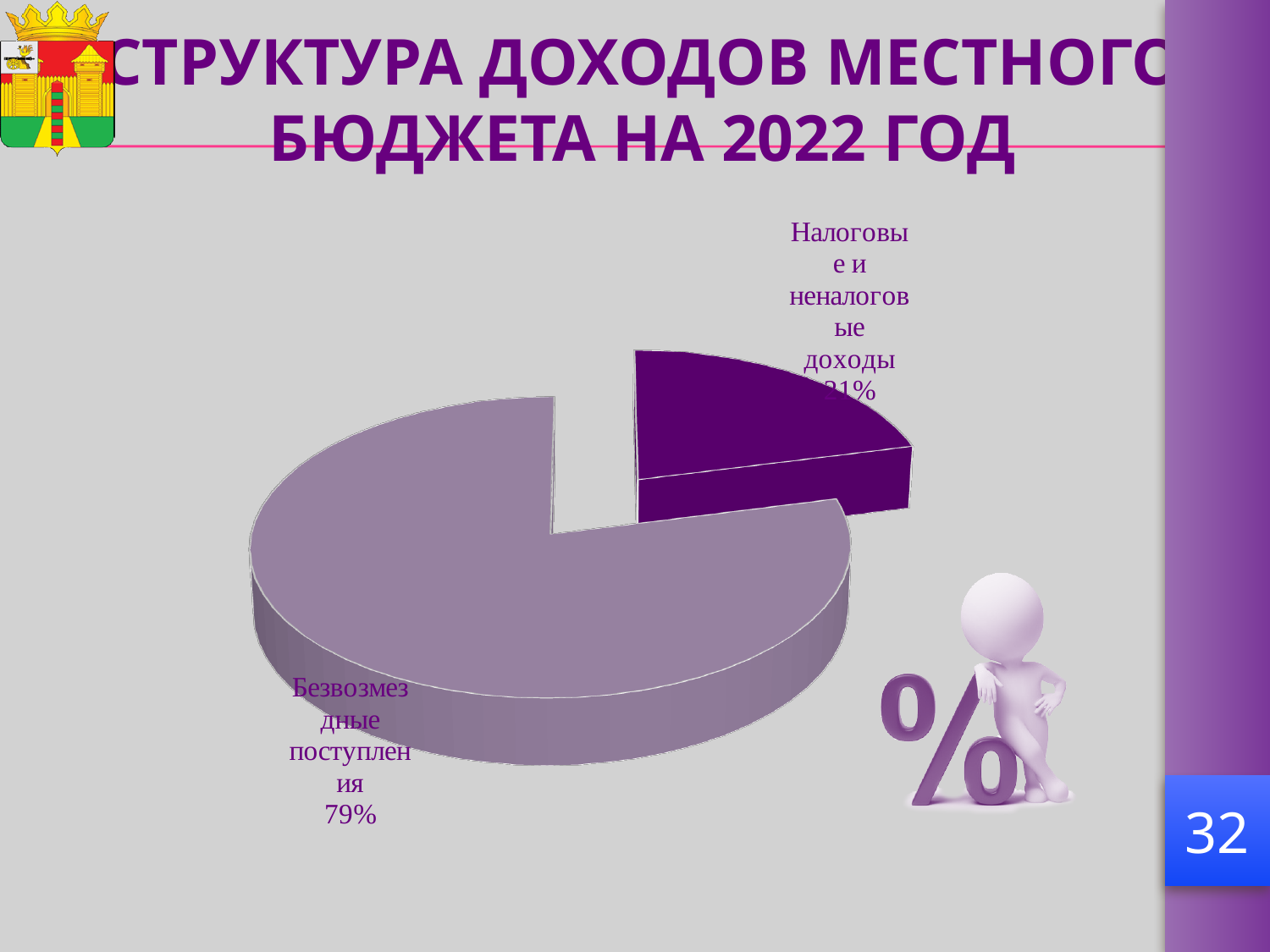
What is the title of the slide containing the chart? СТРУКТУРА ДОХОДОВ МЕСТНОГО БЮДЖЕТА НА 2022 ГОД How many slices does the pie chart have? 2 Which slice is drawn in dark purple? Налоговые и неналоговые доходы Which is larger: "Безвозмездные поступления" or "Налоговые и неналоговые доходы"? Безвозмездные поступления Which category has the smallest slice of the pie? Налоговые и неналоговые доходы What share of the pie does "Безвозмездные поступления" account for? 79% What kind of chart is shown on the slide? pie chart Which category has the largest slice of the pie? Безвозмездные поступления What is the value shown for "Безвозмездные поступления"? 79%